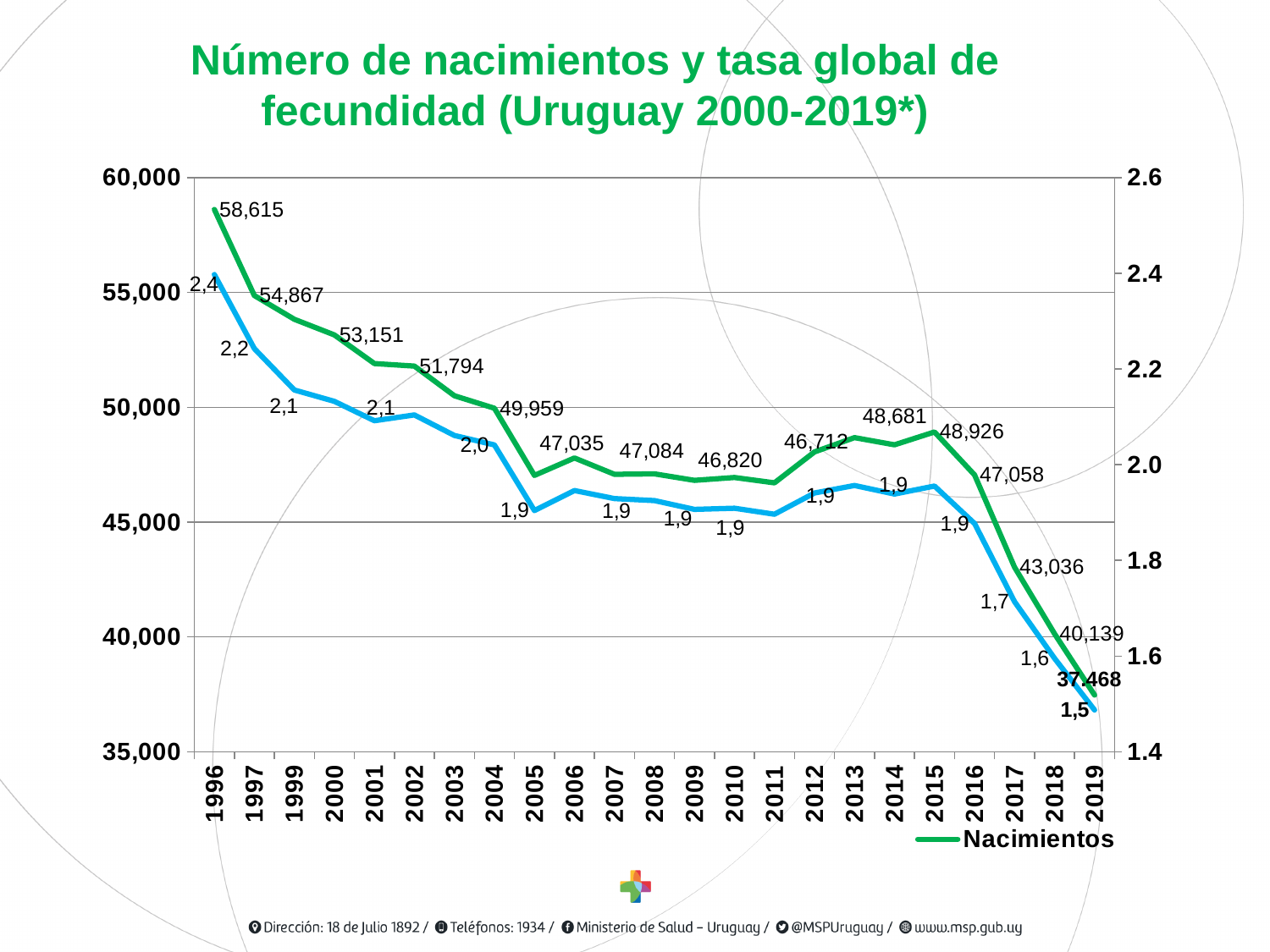
Which year has the highest number of births (Nacimientos)? 1996 What is the number of births (Nacimientos) in 2019? 37,468 Is the number of births in 2010 greater or less than 50,000? less How many years are shown on the x axis? 23 Overall, do the number of births rise or fall from 1996 to 2019? Fall What series name is listed in the legend? Nacimientos What is the number of births (Nacimientos) in 2017? 43,036 Which year has more births, 2013 or 2015? 2015 What is the difference between the number of births in 1996 and in 2019? 21,147 Which year has the lowest number of births (Nacimientos)? 2019 What is the number of births (Nacimientos) in 1996? 58,615 What kind of chart is shown on the slide? Line chart